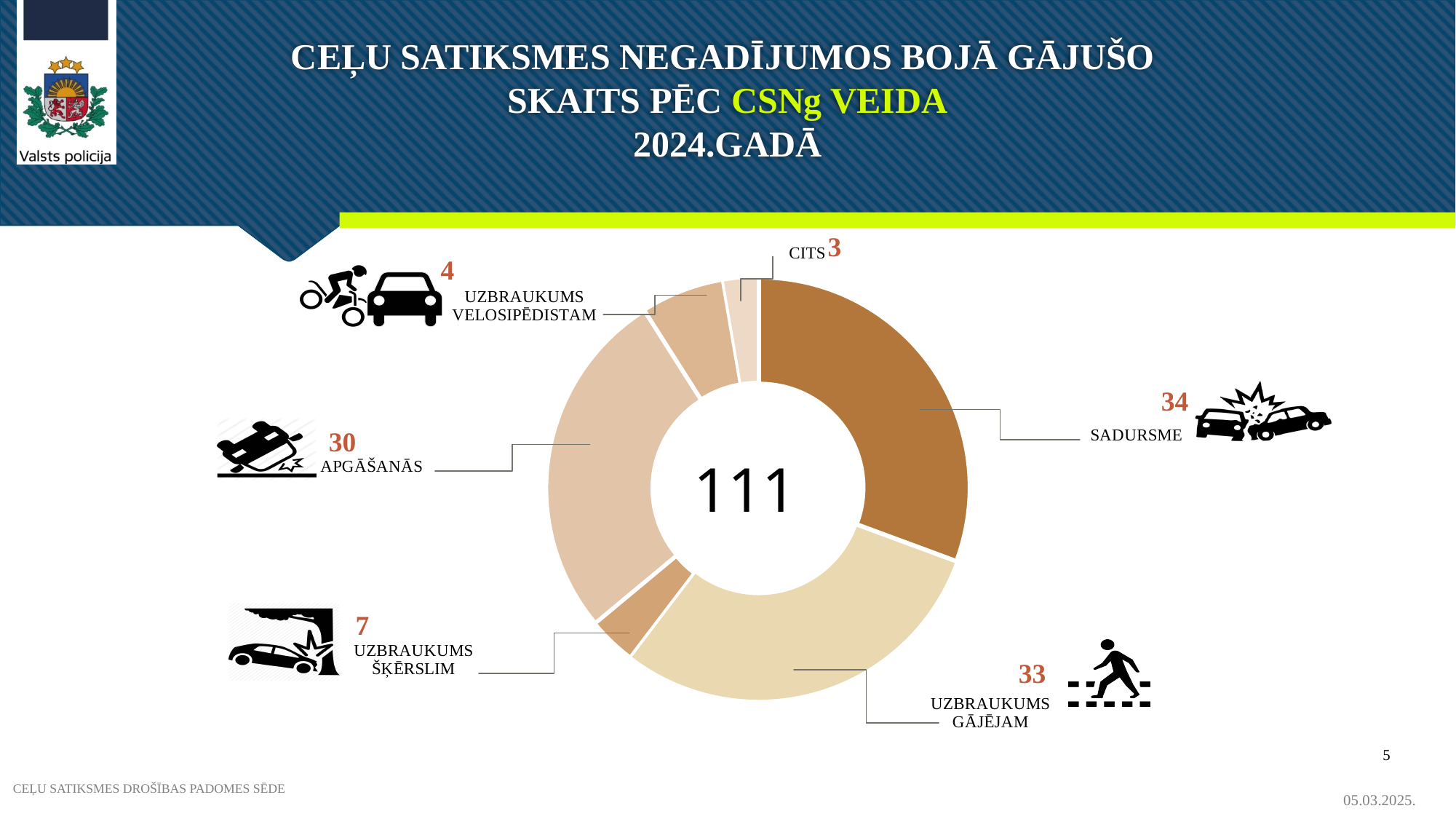
Which is larger, APGĀŠANĀS or UZBRAUKUMS ŠĶĒRSLIM? APGĀŠANĀS What is the value for UZBRAUKUMS GĀJĒJAM? 33 What is the value for UZBRAUKUMS ŠĶĒRSLIM? 7 What type of chart is shown on the slide? Donut (pie) chart What is the difference between SADURSME and UZBRAUKUMS GĀJĒJAM? 1 What total is shown in the centre of the chart? 111 Which category has the lowest value? CITS What is the value for CITS? 3 Which category has the highest value? SADURSME What is the value for APGĀŠANĀS? 30 What is the value for SADURSME? 34 How many categories does the chart show? 6